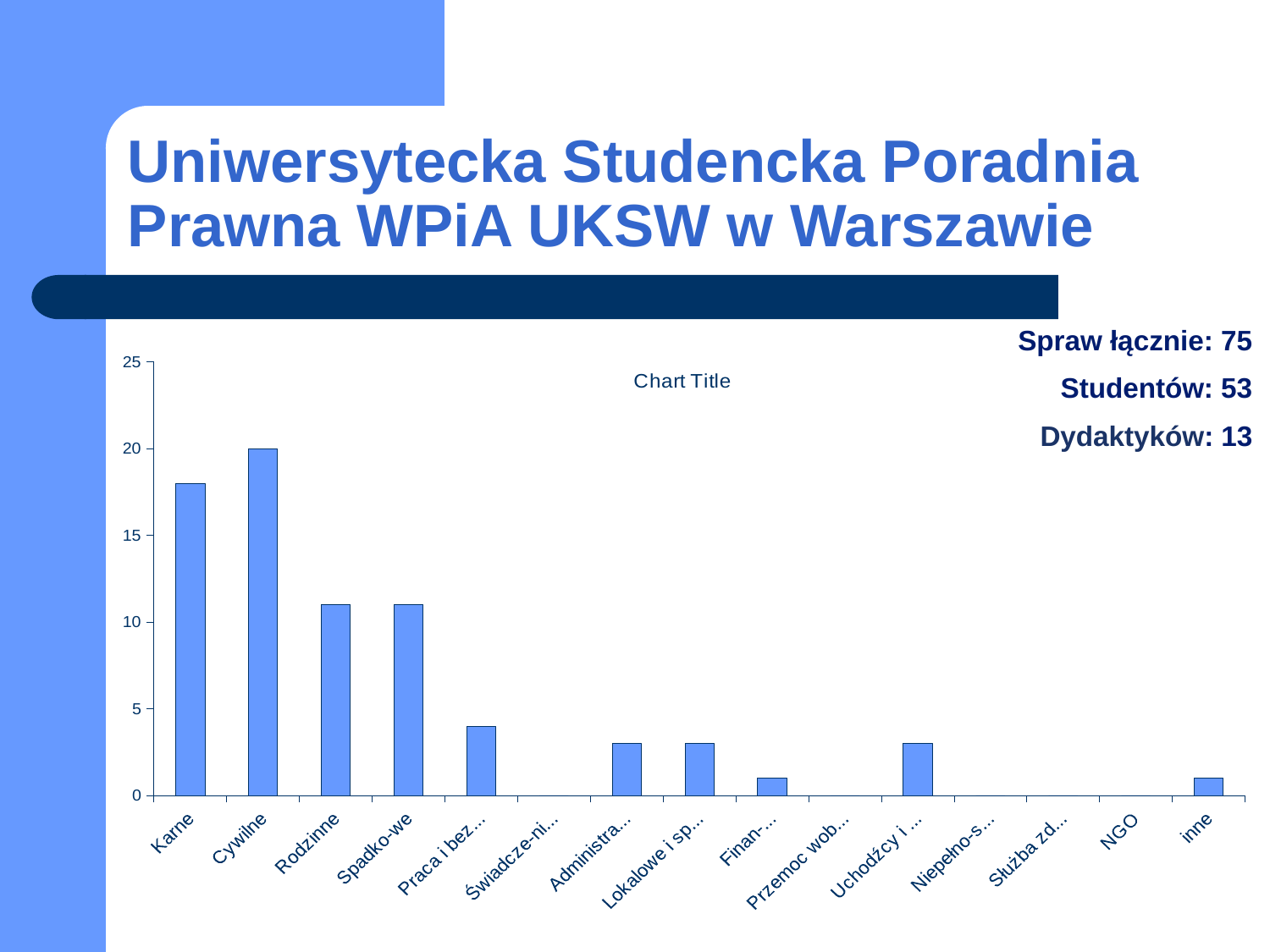
Is the value for Rodzinne greater or less than 10? greater What is the value for Cywilne? 20 How many categories are shown on the x axis? 15 Which category has the highest bar? Cywilne What is the title shown on the chart? Chart Title Is the value for Karne greater or less than 15? greater Is the value for Administra... greater or less than 5? less Which is larger, the value for Cywilne or the value for Karne? Cywilne What kind of chart is shown on the slide? bar chart Which is larger, the value for Karne or the value for Rodzinne? Karne